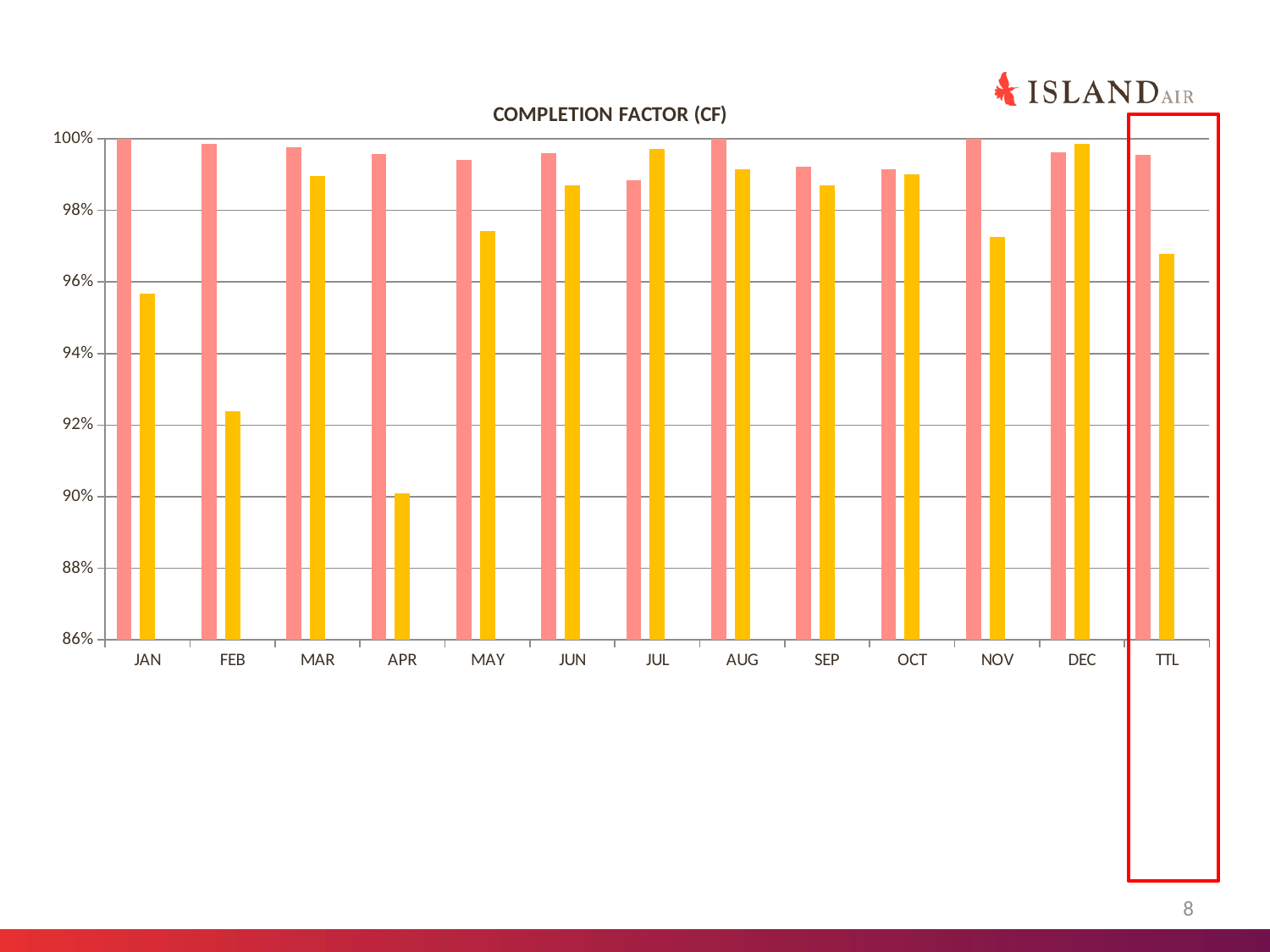
For JAN, which bar is taller, the pink bar or the yellow bar? the pink bar Is the yellow bar for JAN greater or less than 94%? greater Which is larger, the yellow bar for FEB or the yellow bar for MAR? MAR Which category has the lowest yellow bar? APR What is the title of the chart? COMPLETION FACTOR (CF) Which category on the x axis is outlined with a red box? TTL Is the yellow bar for APR greater or less than 92%? less Is the yellow bar for NOV greater or less than 96%? greater What kind of chart is shown on the slide? bar chart How many categories are shown on the x axis of the chart? 13